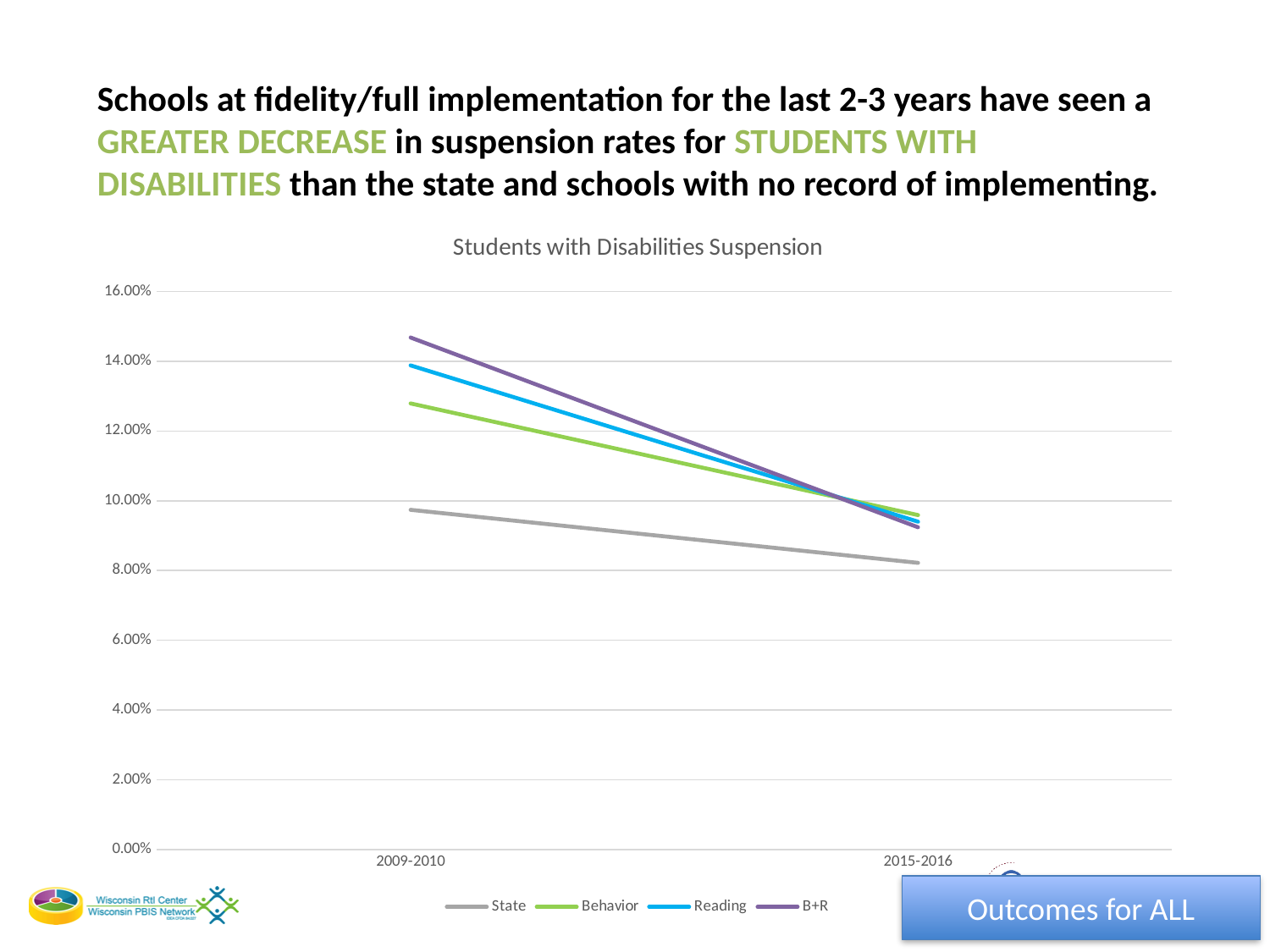
Which series has the lowest value in 2015-2016? State Which series has the lowest value in 2009-2010? State How many points are shown on the x axis? 2 Do the values for the State series rise or fall from 2009-2010 to 2015-2016? fall How many series does the legend list? 4 Is the value for B+R in 2009-2010 greater or less than 14.00%? greater What kind of chart is shown on the slide? line chart Is the value for Behavior in 2009-2010 greater or less than 12.00%? greater In 2009-2010, which is larger, the value for Reading or the value for Behavior? Reading Which series has the highest value in 2009-2010? B+R Is the value for State in 2015-2016 greater or less than 10.00%? less What is the title of the chart? Students with Disabilities Suspension